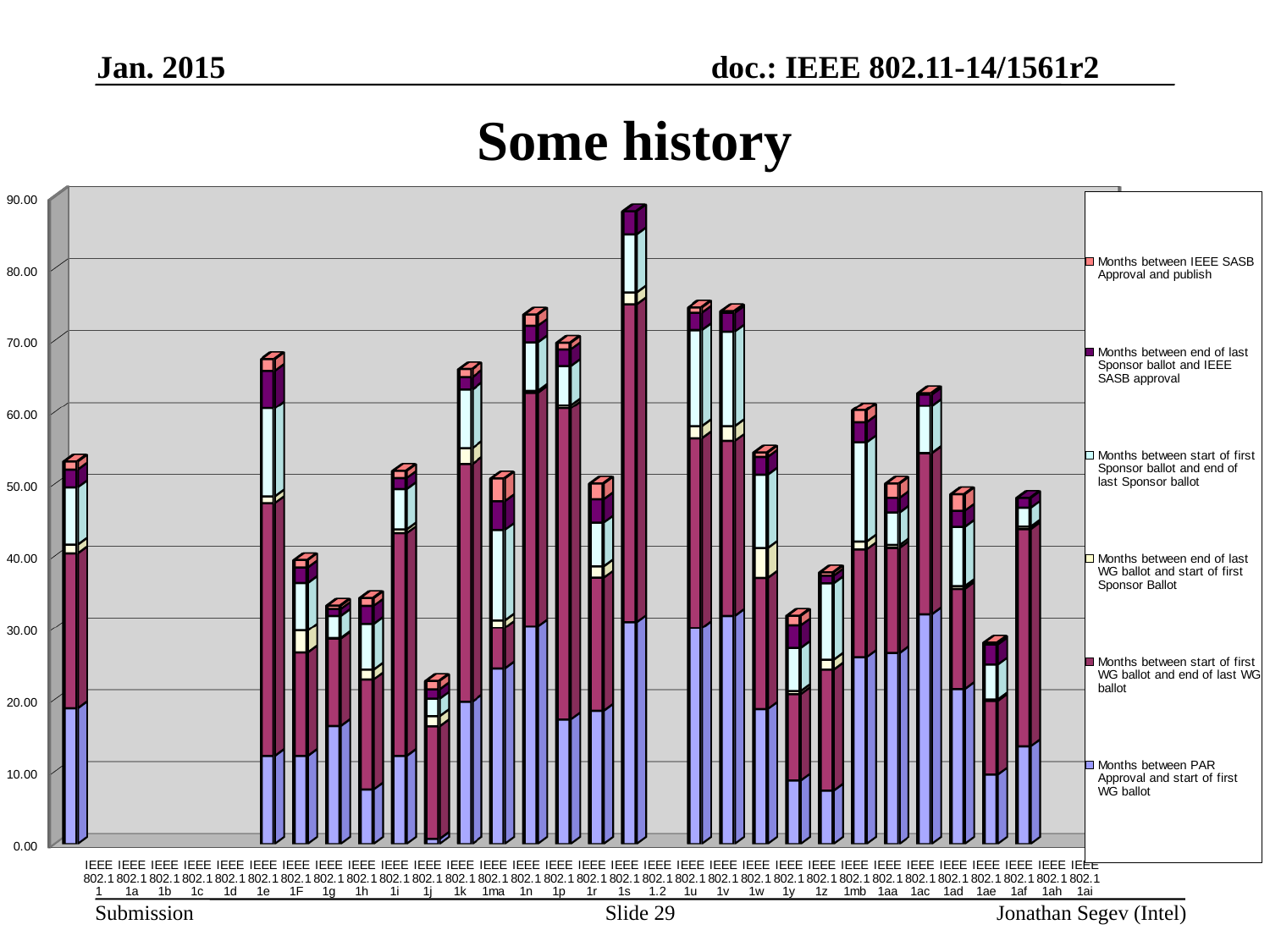
Is the total for IEEE 802.11n greater or less than 70.00? greater What is the title of the slide? Some history Is the total for IEEE 802.11j greater or less than 30.00? less What kind of chart is shown on the slide? Stacked bar chart How many categories are shown along the x axis? 31 Is the total for IEEE 802.11z greater or less than 40.00? less Which series is listed last (at the bottom) in the legend? Months between PAR Approval and start of first WG ballot How many series does the legend list? 6 Which has the taller stacked bar, IEEE 802.11e or IEEE 802.11j? IEEE 802.11e Which category has the tallest stacked bar? IEEE 802.11s